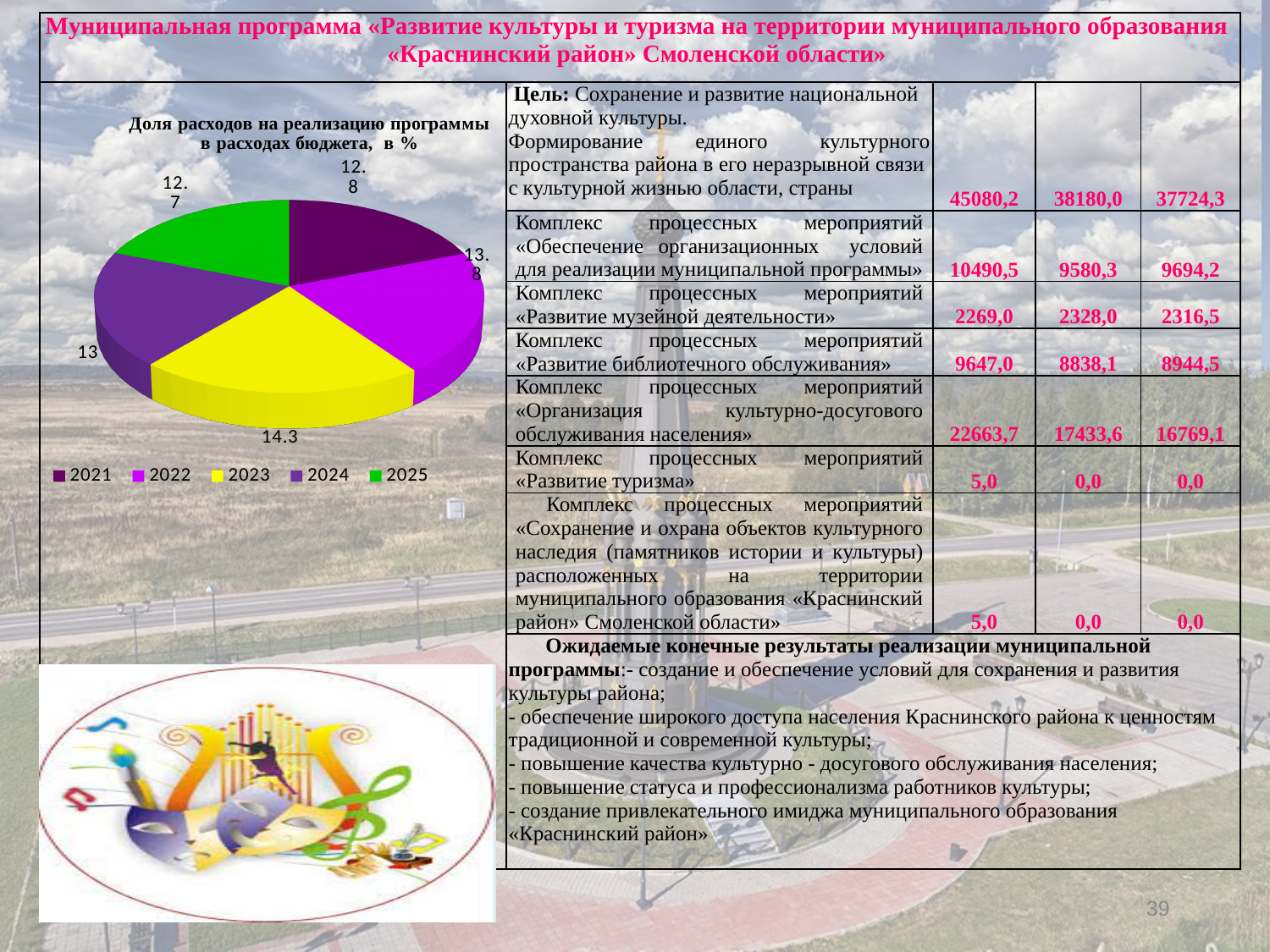
Which colour represents 2023 in the pie chart? Yellow What is the difference between the values for 2023 and 2021 in the pie chart? 1.5 What kind of chart is shown on the slide? Pie chart How many slices does the pie chart have? 5 What is the value for 2024 in the pie chart? 13 What is the value for 2023 in the pie chart? 14.3 How many entries does the legend of the pie chart list? 5 Which is larger in the pie chart, the value for 2022 or the value for 2024? 2022 What is the title of the pie chart? Доля расходов на реализацию программы в расходах бюджета, в % What is the value for 2021 in the pie chart? 12.8 What is the value for 2025 in the pie chart? 12.7 Which year has the largest slice in the pie chart? 2023